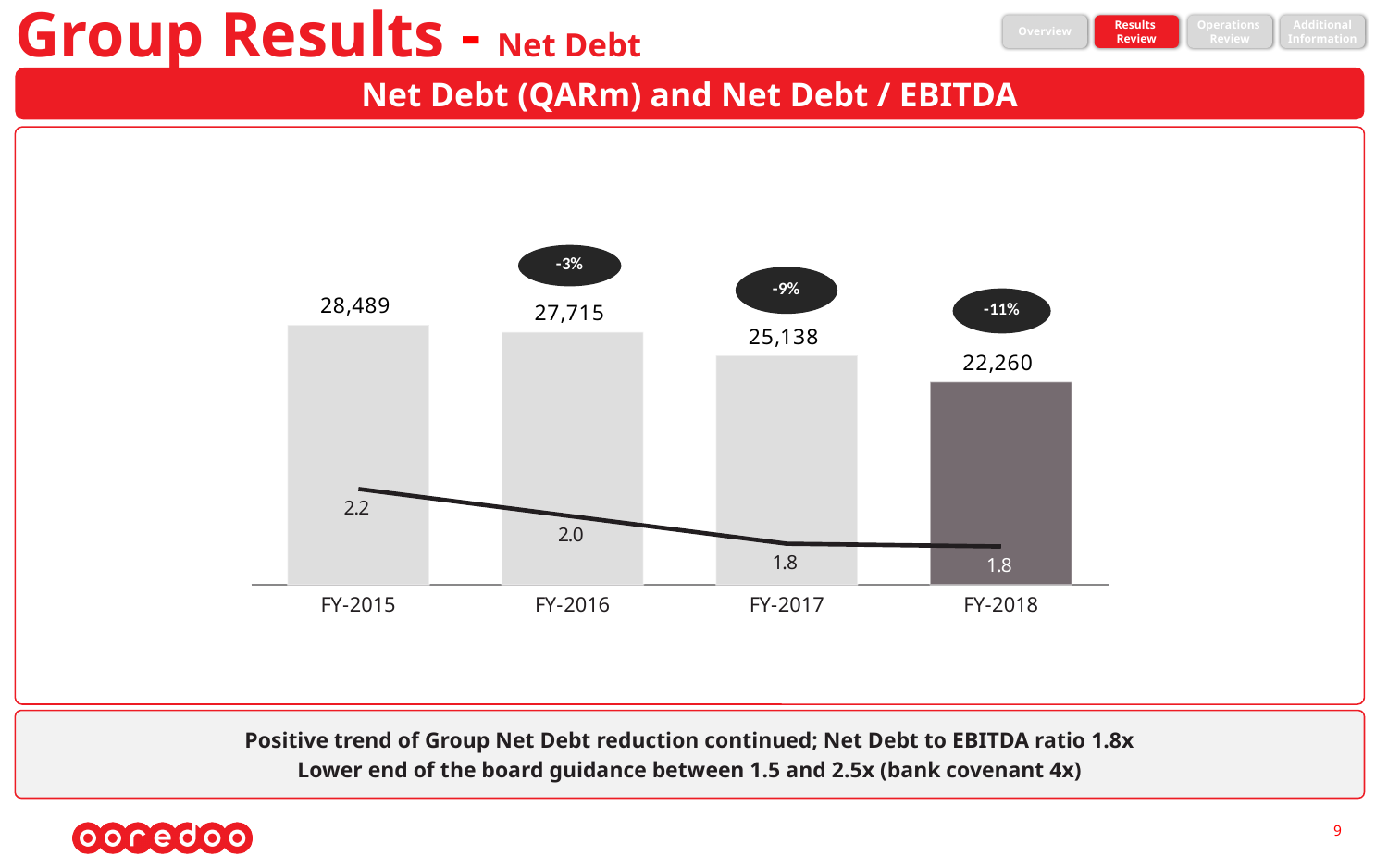
What is the Net Debt / EBITDA ratio for FY-2016? 2.0 What is the title of the chart? Net Debt (QARm) and Net Debt / EBITDA Does Net Debt rise or fall from FY-2015 to FY-2018? Fall How many fiscal years are shown on the chart? 4 Which is larger, the Net Debt for FY-2016 or for FY-2017? FY-2016 What is the Net Debt / EBITDA ratio for FY-2015? 2.2 What percentage change in Net Debt is shown for FY-2017? -9% What is the difference in Net Debt (QARm) between FY-2016 and FY-2017? 2,577 What is the Net Debt (QARm) for FY-2018? 22,260 Which fiscal year has the lowest Net Debt? FY-2018 What is the Net Debt (QARm) for FY-2015? 28,489 Which fiscal year has the highest Net Debt? FY-2015